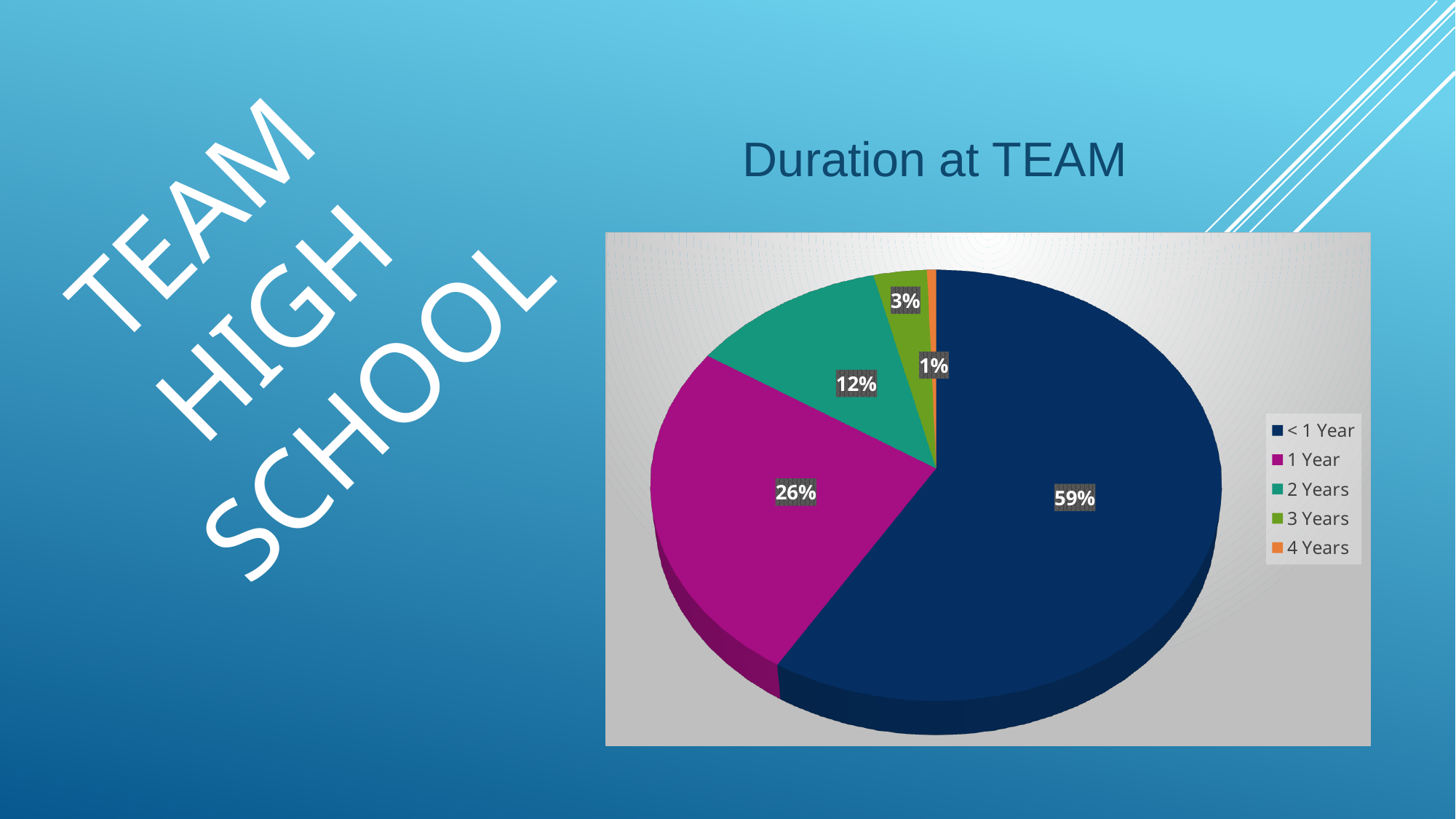
What share of the pie is labelled for the '1 Year' slice? 26% What share of the pie is labelled for the '3 Years' slice? 3% What share of the pie is labelled for the '4 Years' slice? 1% How many categories does the legend list? 5 Which category has the largest slice of the pie? < 1 Year What is the difference in percentage points between the '< 1 Year' slice and the '1 Year' slice? 33 What is the title of the chart? Duration at TEAM Which category has the smallest slice of the pie? 4 Years What kind of chart is shown on the slide? pie chart Which slice is larger, '2 Years' or '3 Years'? 2 Years